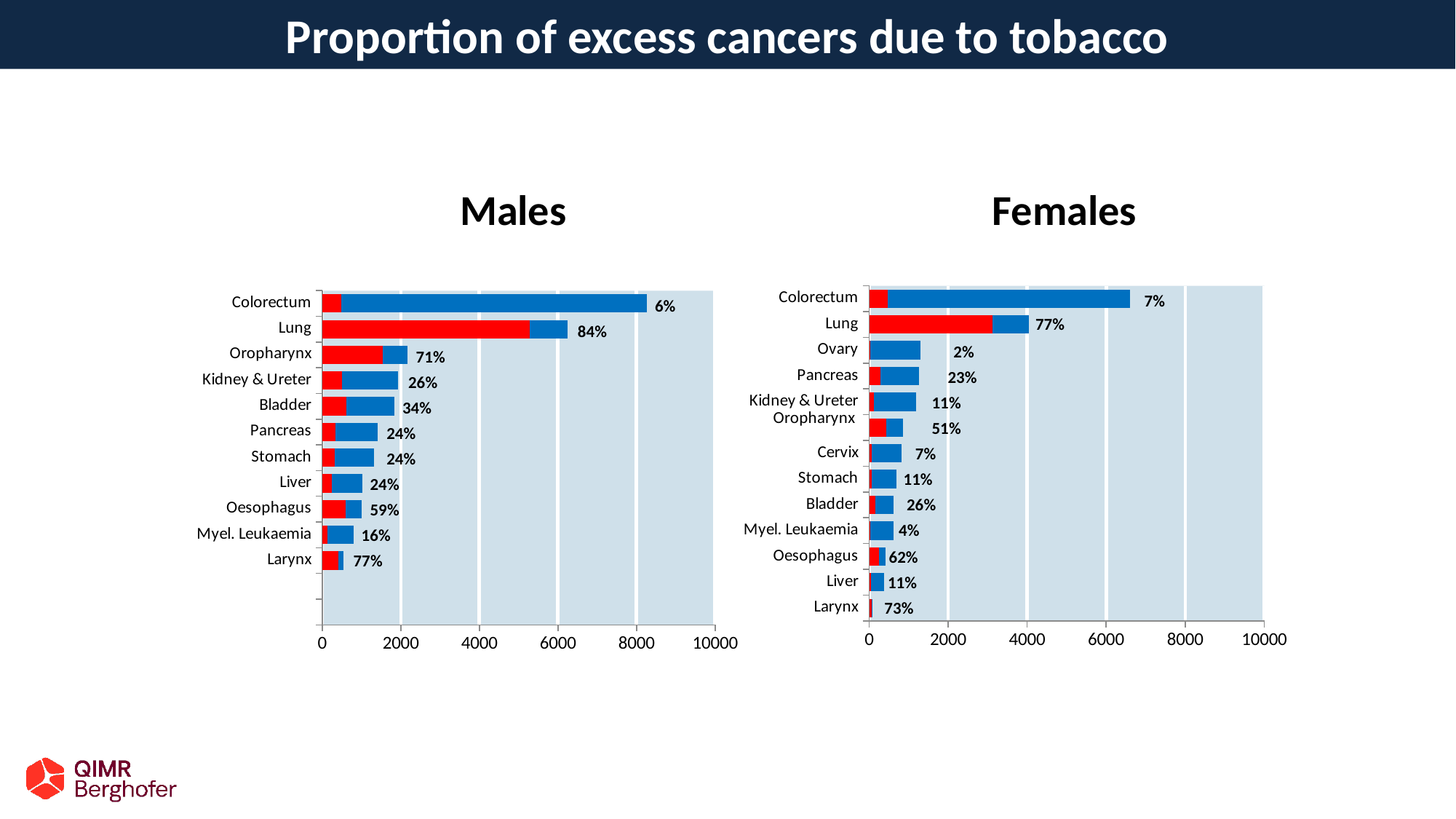
In the Males chart, what is the difference between the percentage labels for Lung and Larynx? 7% In the Females chart, what percentage label is shown for Oesophagus? 62% In the Females chart, which cancer has the lowest percentage label? Ovary In the Females chart, which cancer has the longest bar? Colorectum What type of chart is the Males chart? Bar chart How many cancer categories are listed in the Females chart? 13 In the Males chart, what percentage label is shown for Larynx? 77% In the Males chart, which has the larger percentage label, Oropharynx or Bladder? Oropharynx In the Males chart, what percentage label is shown for Lung? 84% How many cancer categories are listed in the Males chart? 11 In the Females chart, is the total bar length for Colorectum greater or less than 6000? greater In the Males chart, which cancer has the highest percentage label? Lung